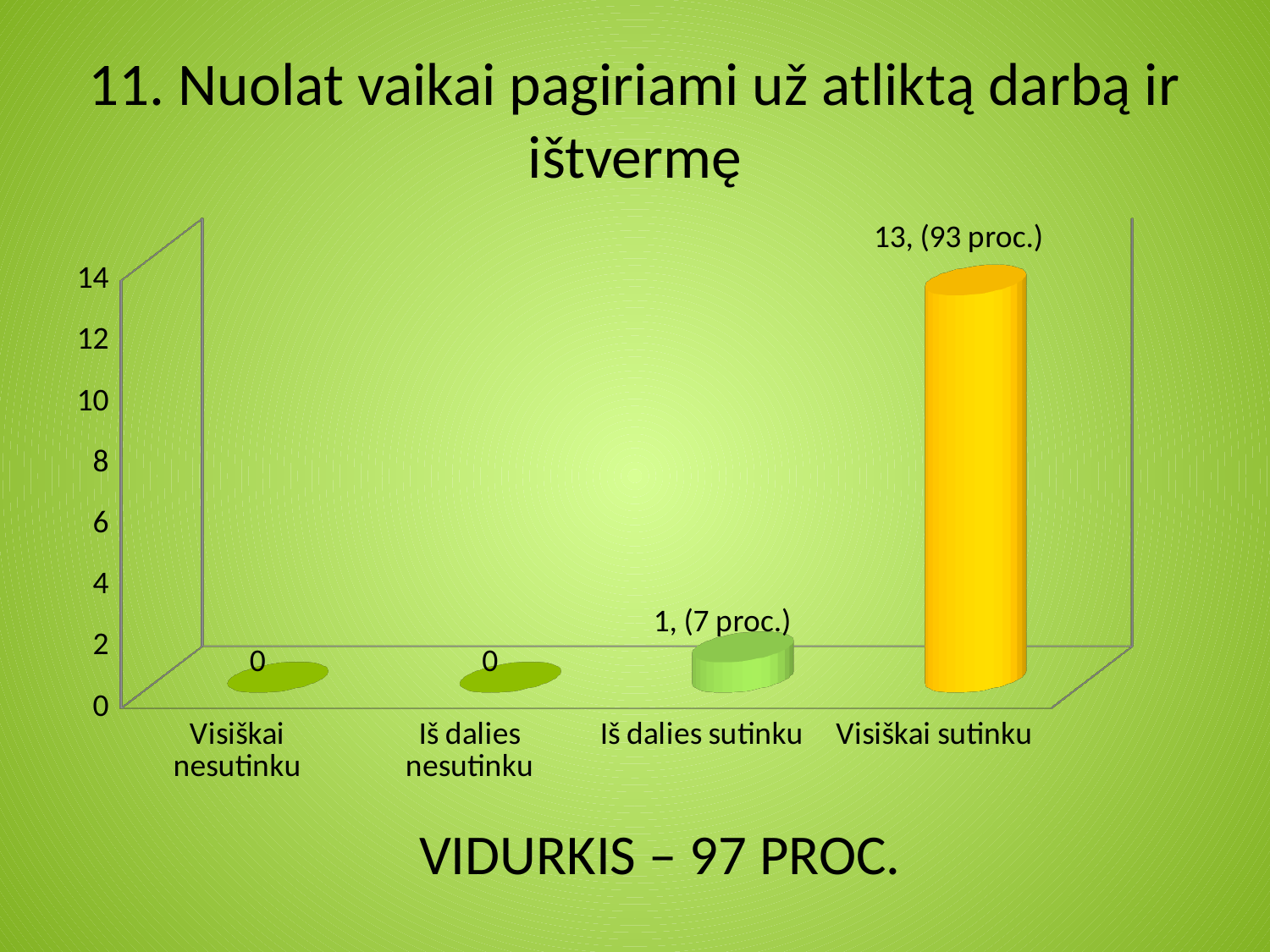
Which category has the highest value? Visiškai sutinku What kind of chart is shown on the slide? bar chart Is the value for Visiškai sutinku greater or less than 10? greater What is the value for Visiškai sutinku? 13, (93 proc.) What is the value for Visiškai nesutinku? 0 What is the value for Iš dalies nesutinku? 0 What is the value for Iš dalies sutinku? 1, (7 proc.) Which is larger, the value for Iš dalies sutinku or the value for Visiškai sutinku? Visiškai sutinku What is the difference between the values for Visiškai sutinku and Iš dalies sutinku? 12 What is the title of the chart? 11. Nuolat vaikai pagiriami už atliktą darbą ir ištvermę How many categories are shown on the x axis? 4 What average (VIDURKIS) is stated below the chart? 97 PROC.